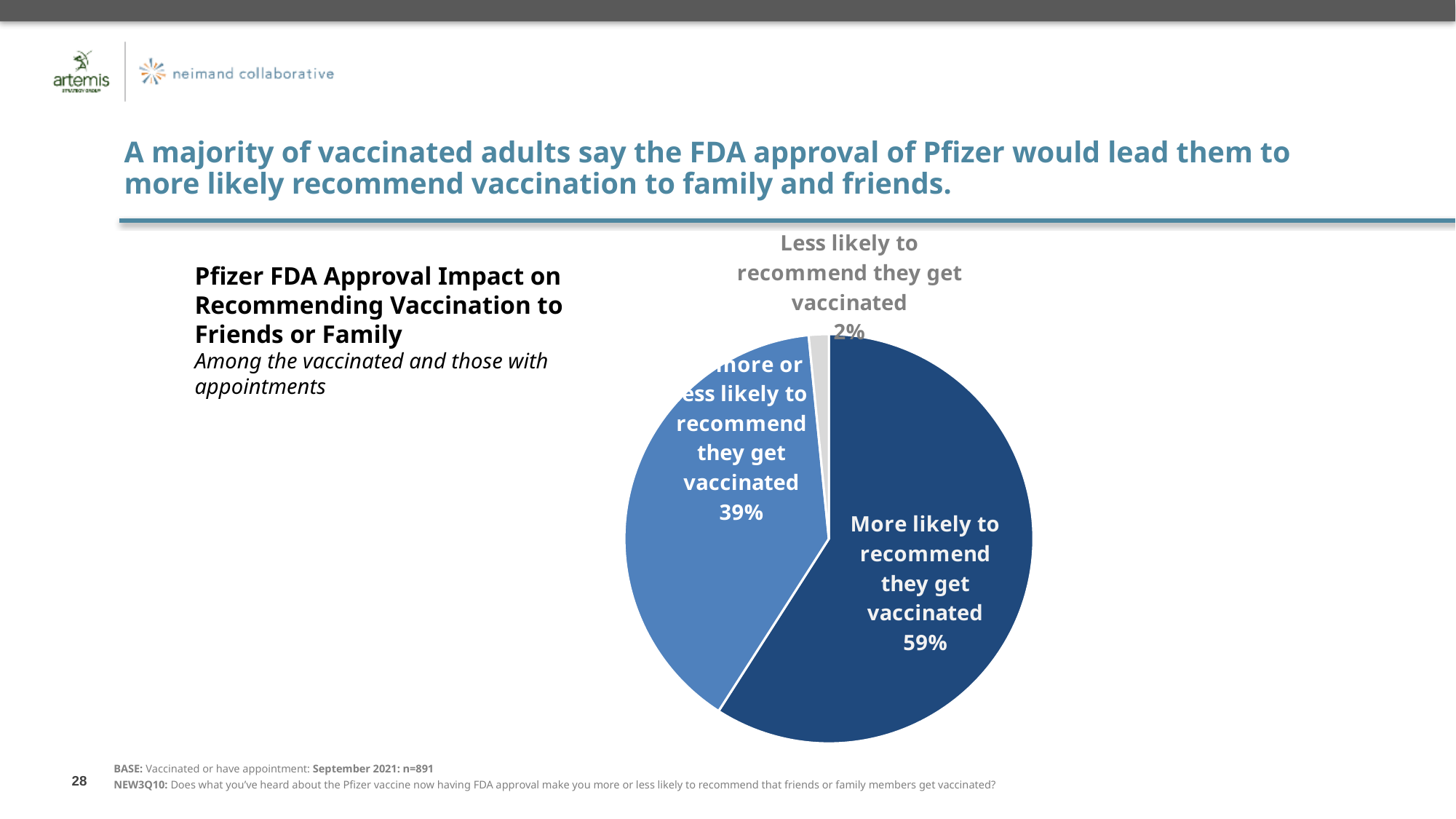
What share of respondents say they are no more or less likely to recommend they get vaccinated? 39% Which response has the smallest share of the pie? Less likely to recommend they get vaccinated How many slices does the pie chart have? 3 What is the difference in percentage points between the 'More likely' and 'No more or less likely' slices? 20 percentage points What share of respondents say they are less likely to recommend they get vaccinated? 2% Which response has the largest share of the pie? More likely to recommend they get vaccinated What colour is the slice for 'Less likely to recommend they get vaccinated'? Grey What share of respondents say they are more likely to recommend they get vaccinated? 59% What is the title of the chart? Pfizer FDA Approval Impact on Recommending Vaccination to Friends or Family What is the combined share of the 'More likely' and 'Less likely' slices? 61% Which is larger: the share for 'More likely to recommend' or the share for 'No more or less likely to recommend'? More likely to recommend they get vaccinated What type of chart is shown on the slide? Pie chart